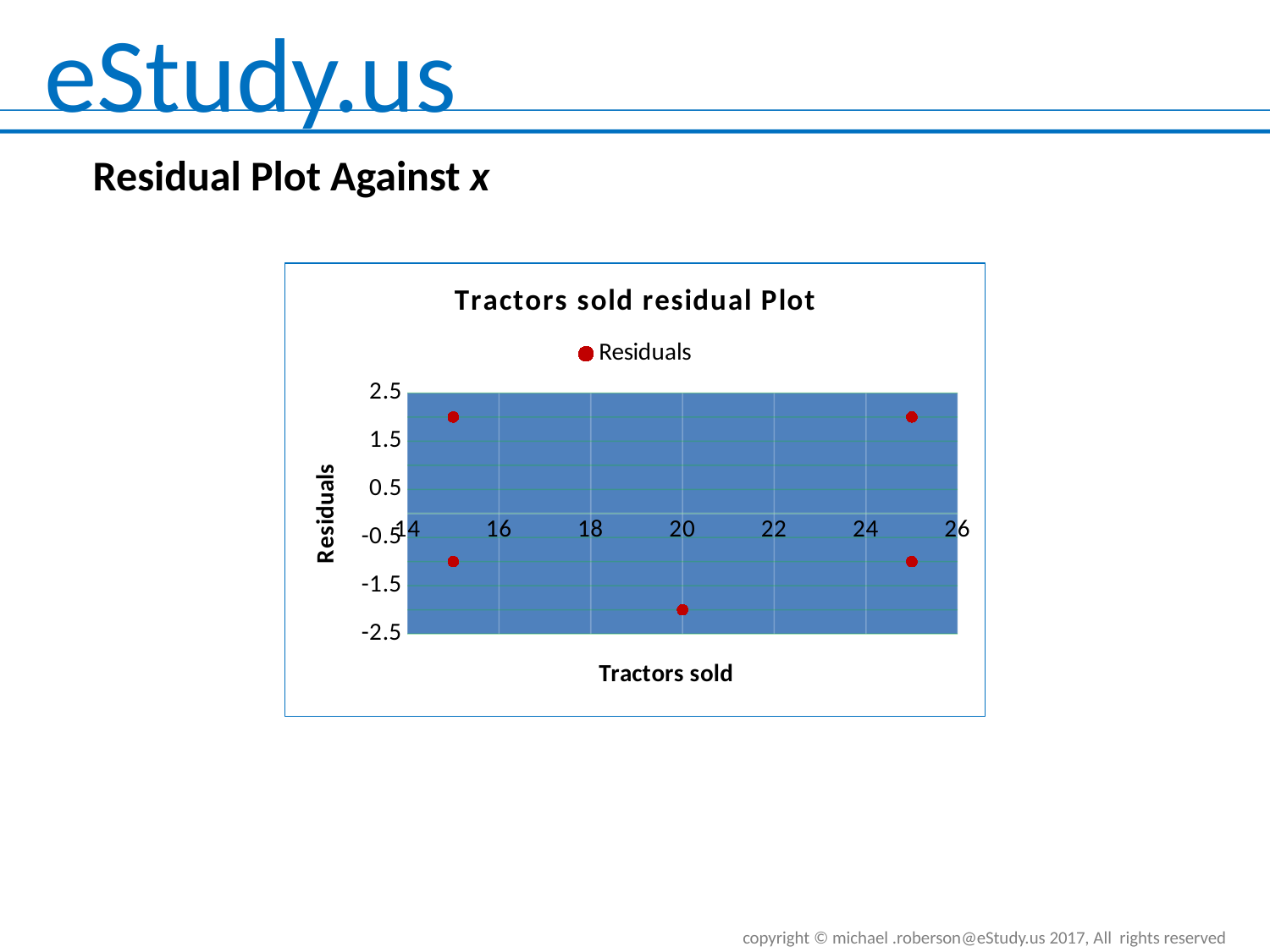
What is the label on the x axis of the chart? Tractors sold How many data points are plotted in the chart? 5 Is the residual for the upper point at 15 tractors sold greater or less than 1.5? greater Is the residual for the lower point at 25 tractors sold greater or less than -0.5? less Which has the larger residual: the point at 20 tractors sold or the lower point at 25 tractors sold? the lower point at 25 tractors sold How many points are plotted at 15 tractors sold? 2 What kind of chart is shown on the slide? scatter plot How many series does the legend list? 1 Is the residual for the point at 20 tractors sold greater or less than -1.5? less What is the title of the chart? Tractors sold residual Plot At which value of Tractors sold is the lowest residual plotted? 20